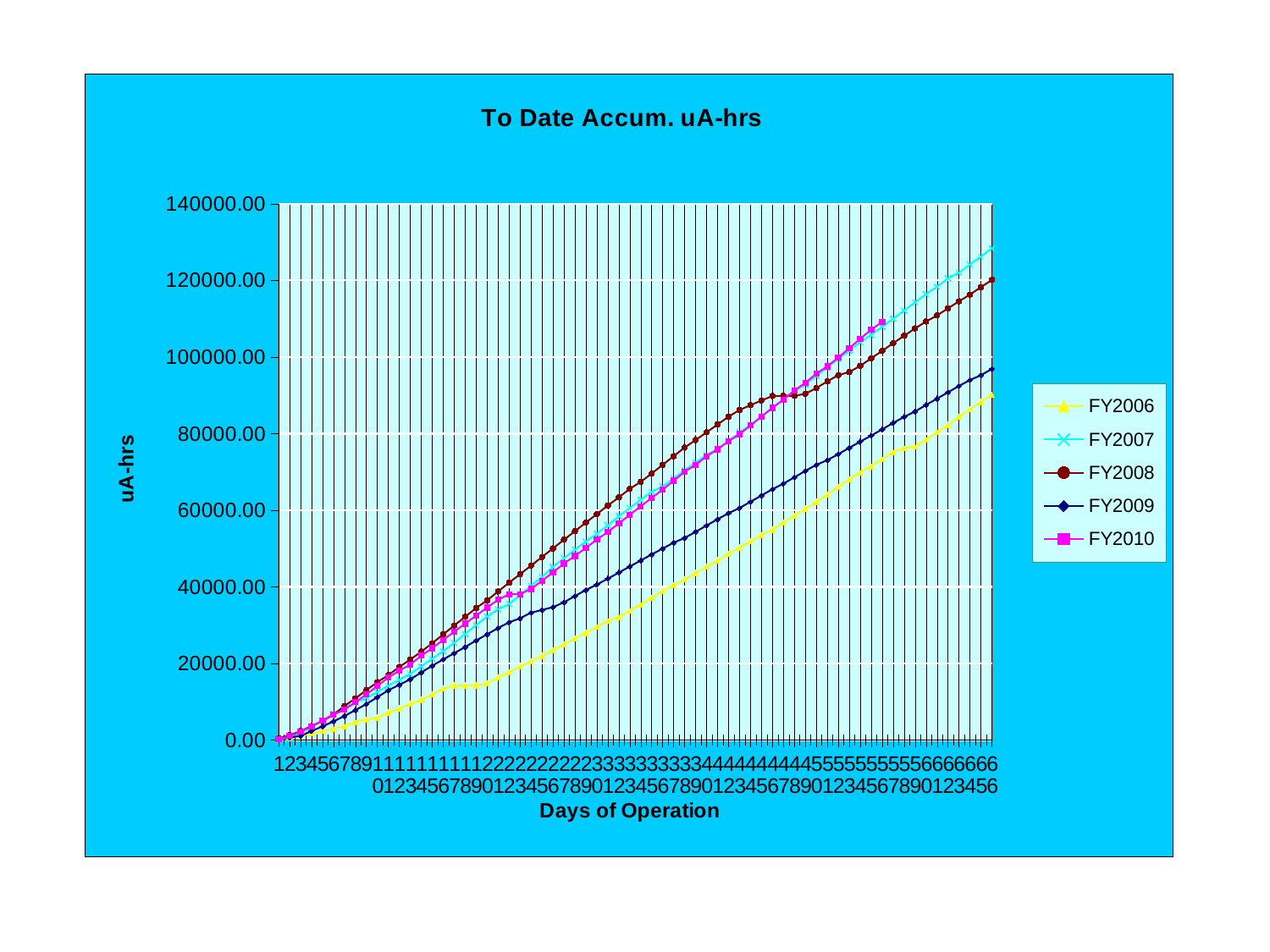
How many series does the legend list? 5 Which series reaches the highest value at the right end of the chart? FY2007 Is the final value for FY2008 greater or less than 100000.00? greater Is the final value for FY2007 greater or less than 120000.00? greater Do the values for each series rise or fall as the days of operation increase? rise What kind of chart is shown on the slide? line chart At the right end of the chart, which is larger, the value for FY2008 or the value for FY2009? FY2008 Is the final value for FY2006 greater or less than 100000.00? less What is the title of the chart? To Date Accum. uA-hrs Which series has the lowest value at the right end of the chart? FY2006 What is the label of the x axis? Days of Operation At the right end of the chart, which is larger, the value for FY2007 or the value for FY2006? FY2007